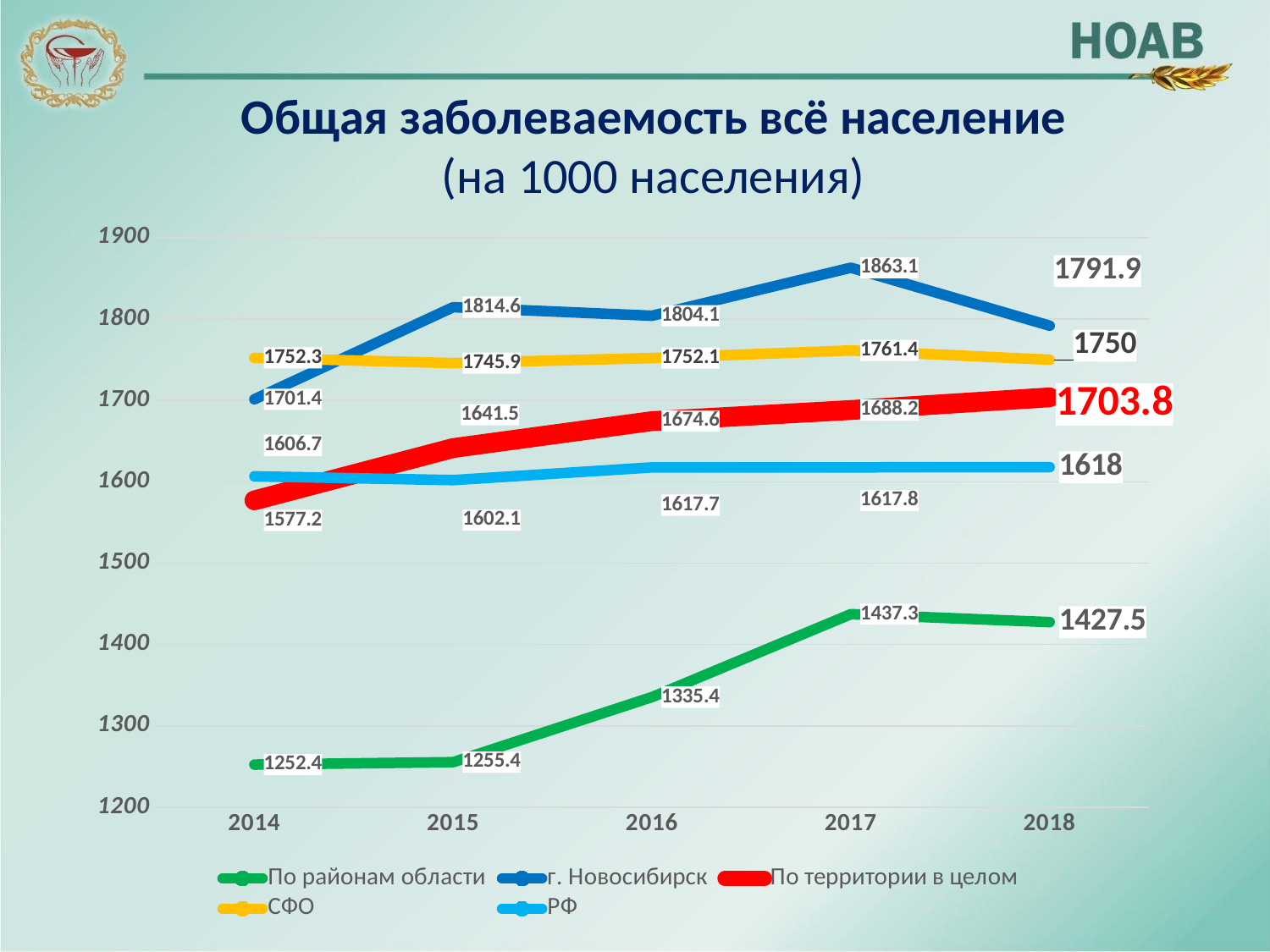
What is the difference between the По районам области values for 2017 and 2016? 101.9 What is the value for г. Новосибирск in 2017? 1863.1 How many years are shown on the x axis? 5 In which year does г. Новосибирск reach its highest value? 2017 What is the value for По территории в целом in 2018? 1703.8 What kind of chart is shown on the slide? line chart In 2018, which is larger: the value for СФО or for г. Новосибирск? г. Новосибирск Does the value for По территории в целом rise or fall from 2014 to 2018? rises What is the value for РФ in 2015? 1602.1 How many series does the legend list? 5 In which year is the value for По районам области the lowest? 2014 Is the value for По районам области in 2016 greater or less than 1300? greater